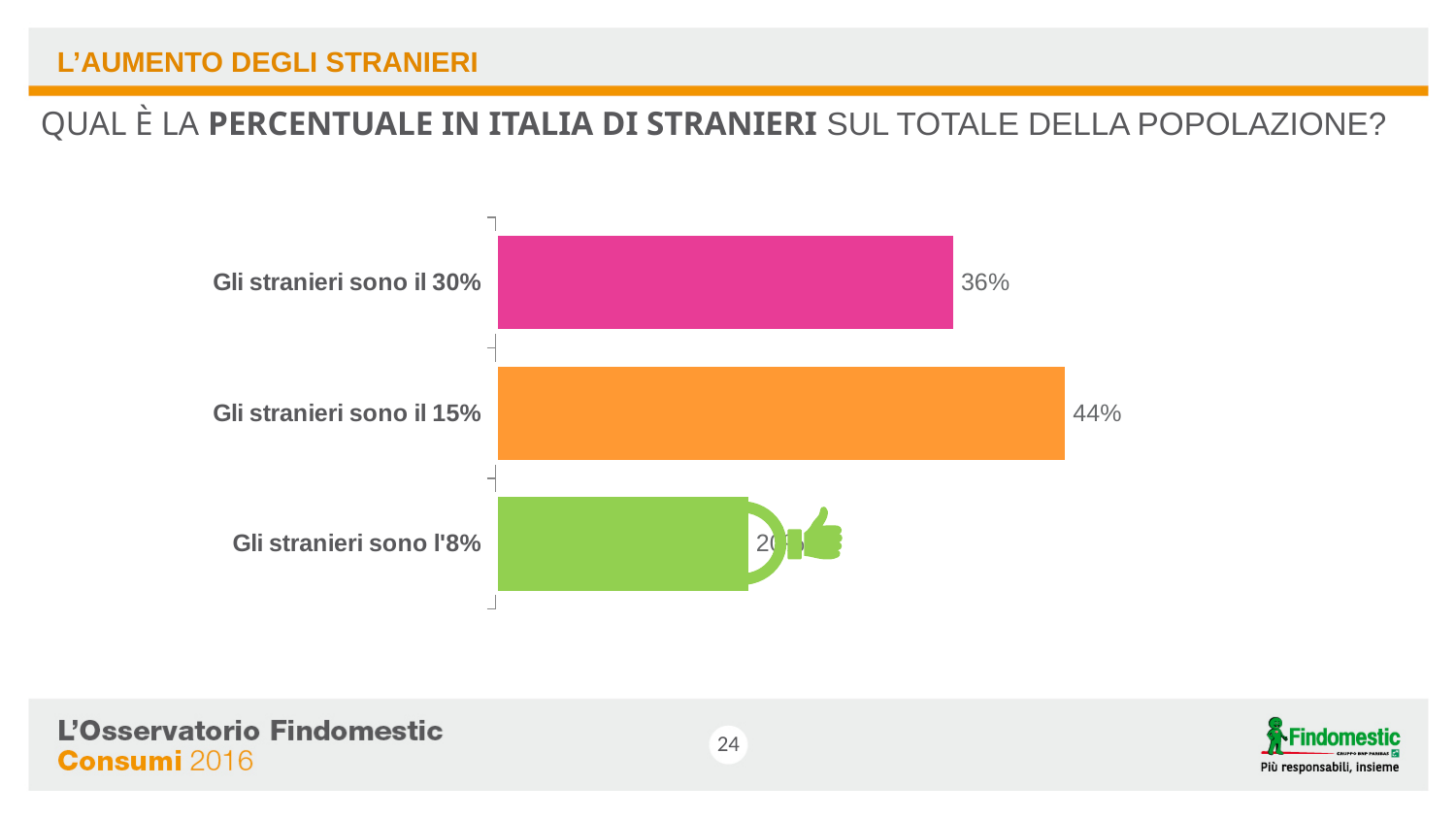
What is the difference between the percentages for "Gli stranieri sono il 15%" and "Gli stranieri sono il 30%"? 8% Which answer option has the highest percentage? Gli stranieri sono il 15% Which answer option has the lowest percentage? Gli stranieri sono l'8% What percentage of respondents answered "Gli stranieri sono il 15%"? 44% What colour is the bar for "Gli stranieri sono il 30%"? Pink How many answer options are shown in the chart? 3 Which has a larger value: "Gli stranieri sono il 30%" or "Gli stranieri sono l'8%"? Gli stranieri sono il 30% Which has a larger value: "Gli stranieri sono il 15%" or "Gli stranieri sono il 30%"? Gli stranieri sono il 15% What type of chart is shown on the slide? Bar chart What colour is the bar for "Gli stranieri sono il 15%"? Orange What percentage of respondents answered "Gli stranieri sono il 30%"? 36%